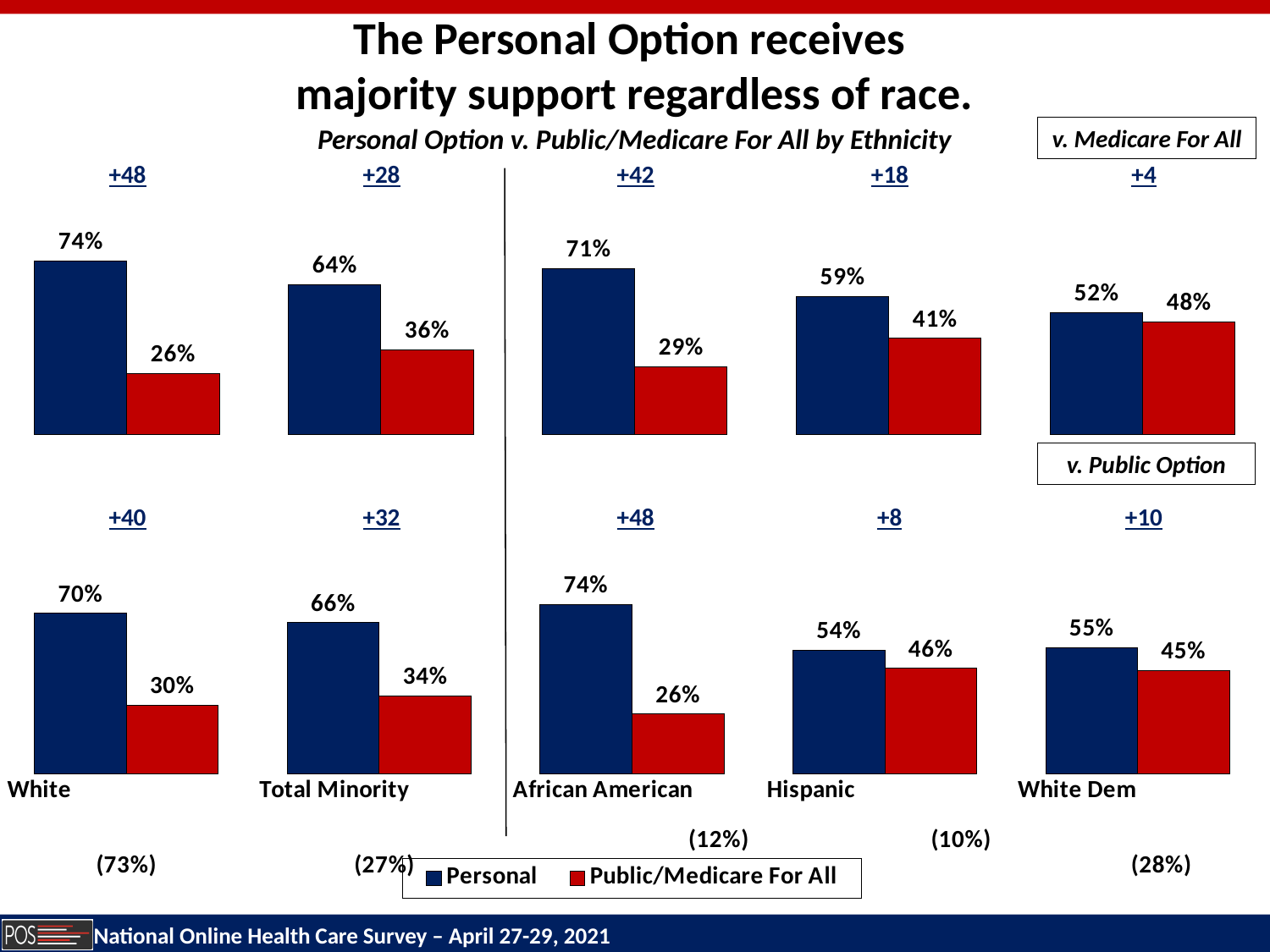
How many categories are shown along the bottom of the charts? 5 In the bottom 'v. Public Option' chart, what is the Personal value for African American? 74% In the bottom 'v. Public Option' chart, which category has the highest Personal value? African American In the top 'v. Medicare For All' chart, what is the difference between the Personal and Public/Medicare For All values for Total Minority? 28 How many series does the legend list? 2 In the top 'v. Medicare For All' chart, which category has the lowest Personal value? White Dem In the bottom 'v. Public Option' chart, what is the difference between the Personal and Public/Medicare For All values for Hispanic? 8 In the bottom 'v. Public Option' chart, which is larger for White: the Personal value or the Public/Medicare For All value? Personal In the top 'v. Medicare For All' chart, what is the Public/Medicare For All value for Hispanic? 41% In the bottom 'v. Public Option' chart, what is the Public/Medicare For All value for White Dem? 45% In the top 'v. Medicare For All' chart, what is the Personal value for White? 74% What kind of chart is used on this slide? Bar chart